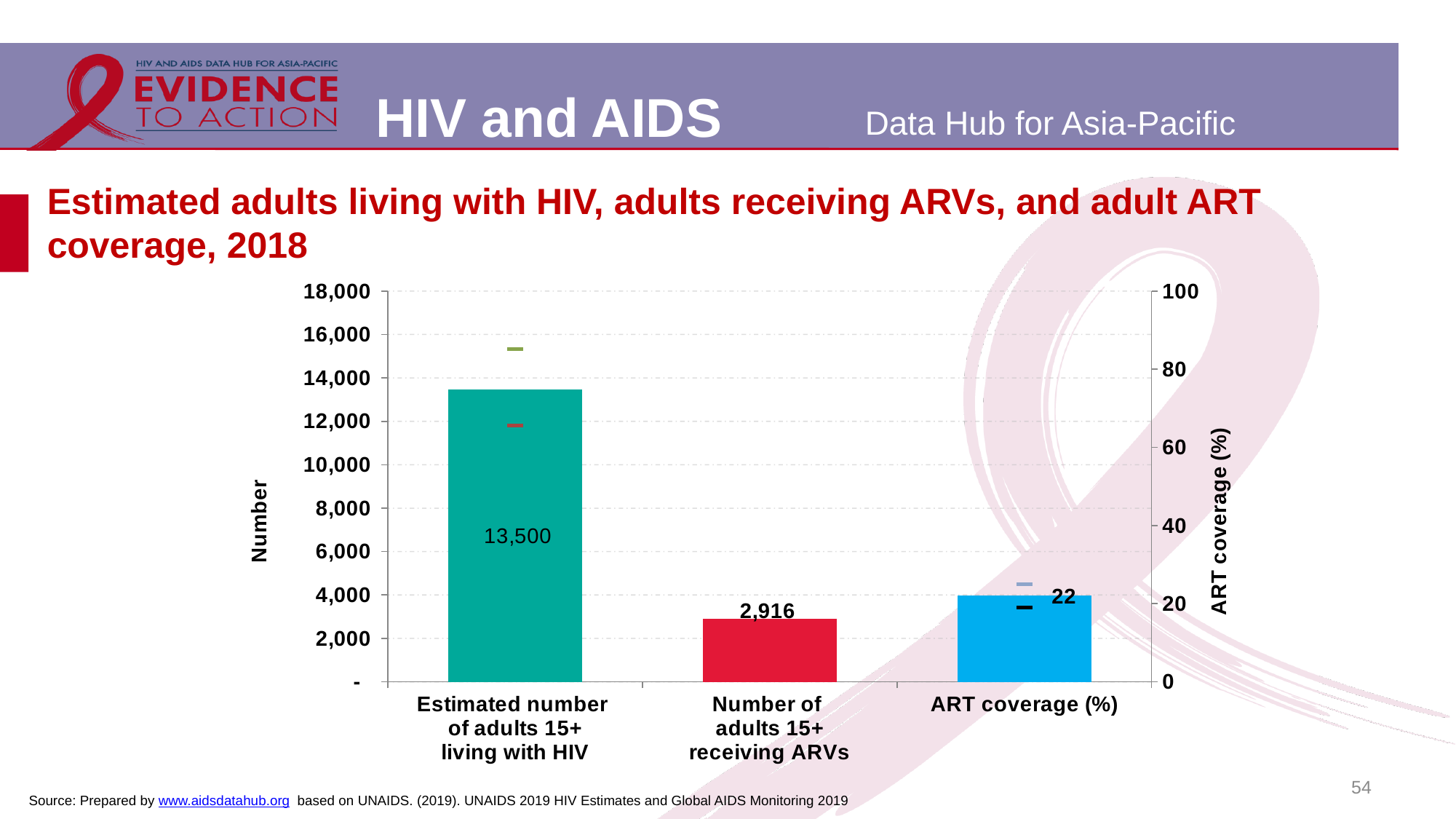
Is the ART coverage (%) value greater or less than 40 on the right-hand axis? less What is the ART coverage (%) value shown on the chart? 22 Is the value for the estimated number of adults 15+ living with HIV greater or less than 12,000? greater Which category has the tallest bar on the chart? Estimated number of adults 15+ living with HIV What type of chart is shown on the slide? Bar chart What is the number of adults 15+ receiving ARVs shown on the chart? 2,916 What is the label of the right-hand vertical axis of the chart? ART coverage (%) What is the difference between the estimated number of adults 15+ living with HIV and the number of adults 15+ receiving ARVs? 10,584 What is the estimated number of adults 15+ living with HIV shown on the chart? 13,500 Which is larger: the estimated number of adults 15+ living with HIV or the number of adults 15+ receiving ARVs? Estimated number of adults 15+ living with HIV How many bars are plotted on the chart? 3 Is the value for the number of adults 15+ receiving ARVs greater or less than 4,000? less